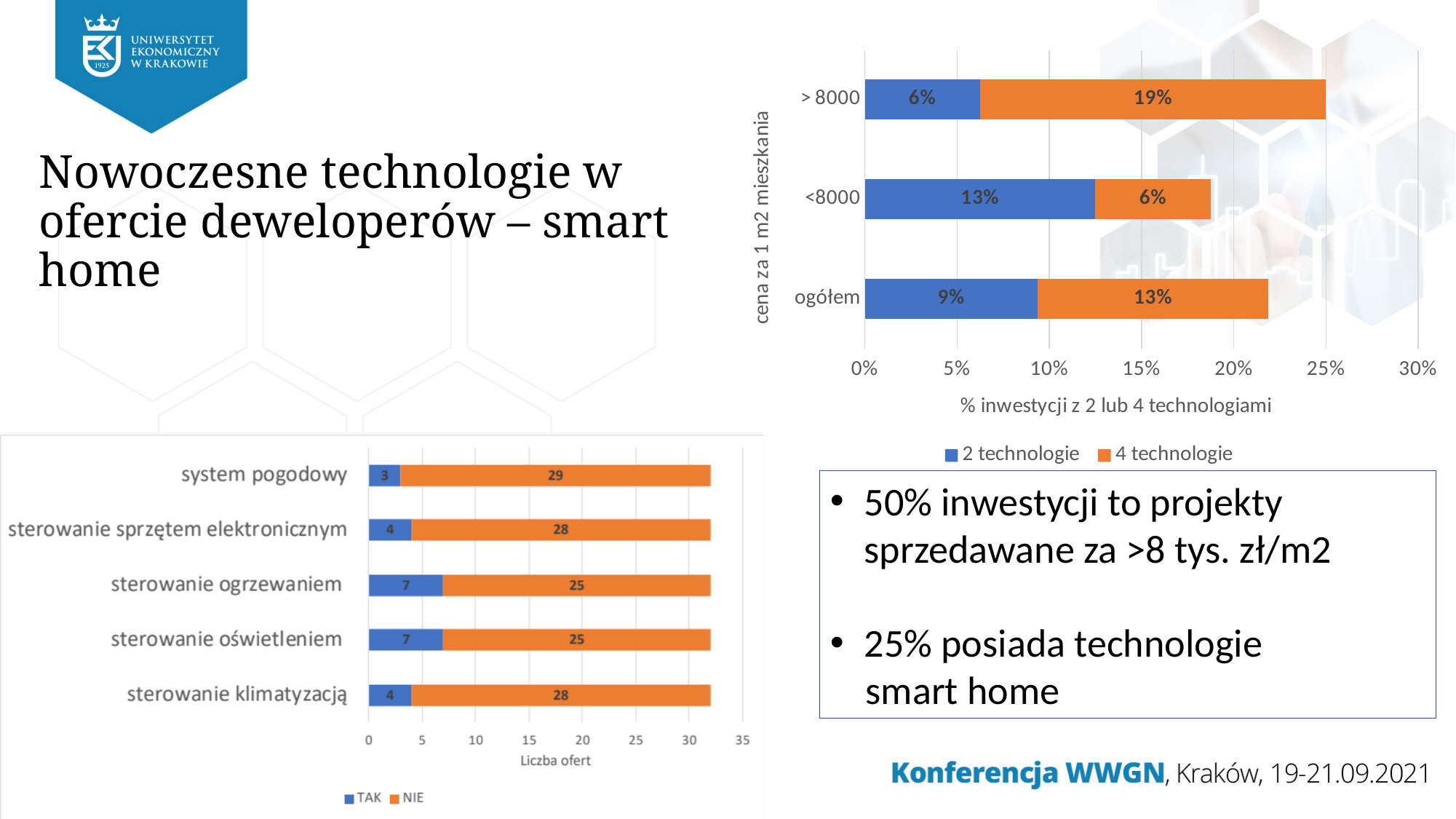
In the top-right chart, how many series does the legend list? 2 In the top-right chart, which category has the highest value for '4 technologie'? > 8000 In the bottom-left chart, how many technology categories are shown? 5 In the bottom-left chart, what is the 'TAK' value for 'sterowanie ogrzewaniem'? 7 What kind of chart is the bottom-left chart? Stacked bar chart In the top-right chart, what is the value for '4 technologie' in the '<8000' category? 6% In the top-right chart, what is the x-axis title? % inwestycji z 2 lub 4 technologiami In the top-right chart, what is the total of the stacked bar for 'ogółem'? 22% In the top-right chart, what is the difference between the '4 technologie' and '2 technologie' values for '> 8000'? 13% In the bottom-left chart, what is the 'NIE' value for 'system pogodowy'? 29 In the top-right chart, what is the value for '2 technologie' in the '> 8000' category? 6% In the bottom-left chart, which category has the lowest 'TAK' value? system pogodowy